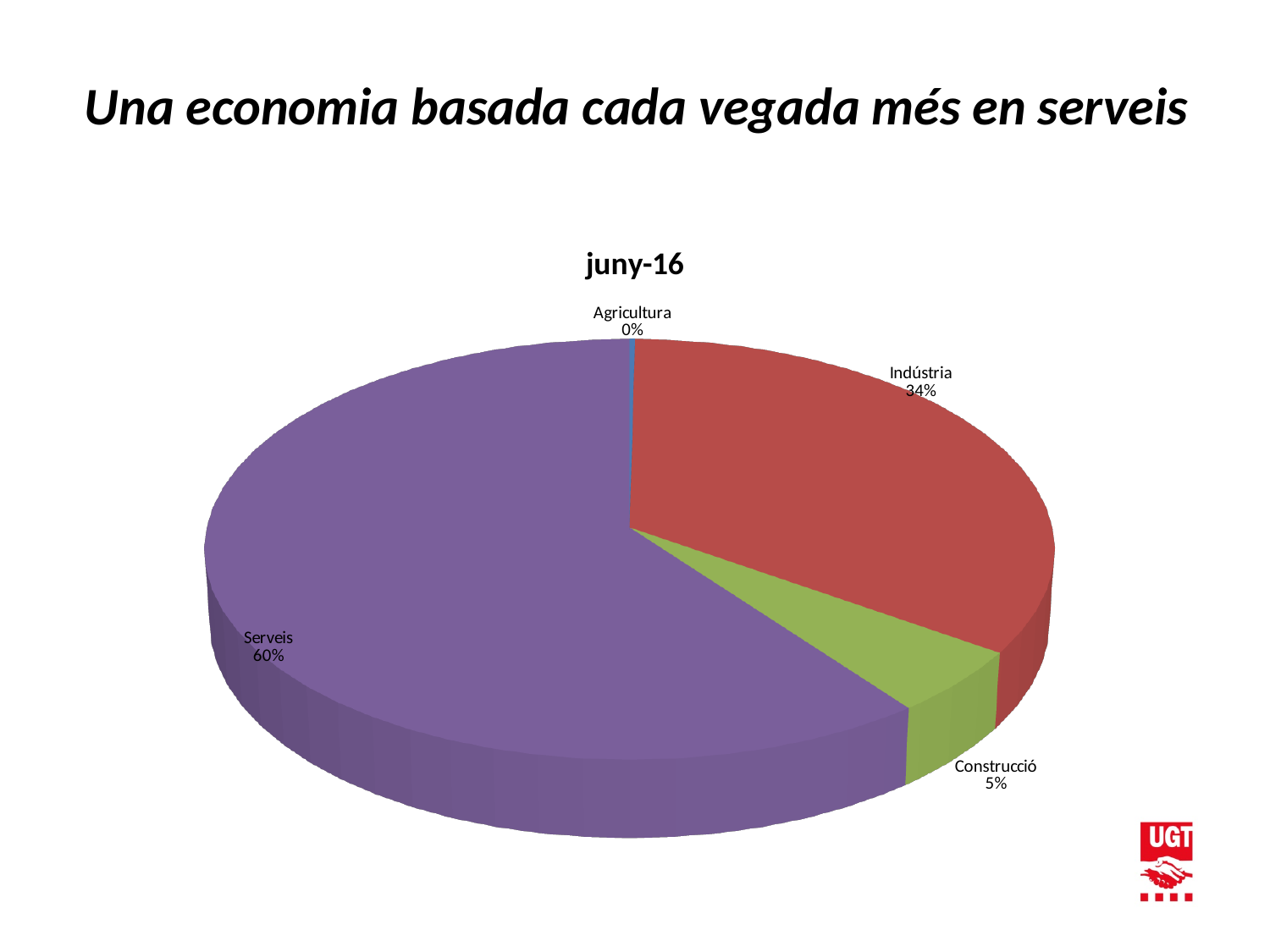
What kind of chart is shown on the slide? Pie chart What share of the pie does Indústria have? 34% Which category has the largest slice? Serveis What is the difference between the shares of Serveis and Indústria? 26% What share of the pie does Serveis have? 60% What share of the pie does Construcció have? 5% Which is larger, the share of Indústria or the share of Construcció? Indústria Which category has the smallest slice? Agricultura What is the chart's title? juny-16 What colour is the Serveis slice? Purple How many categories are shown in the pie chart? 4